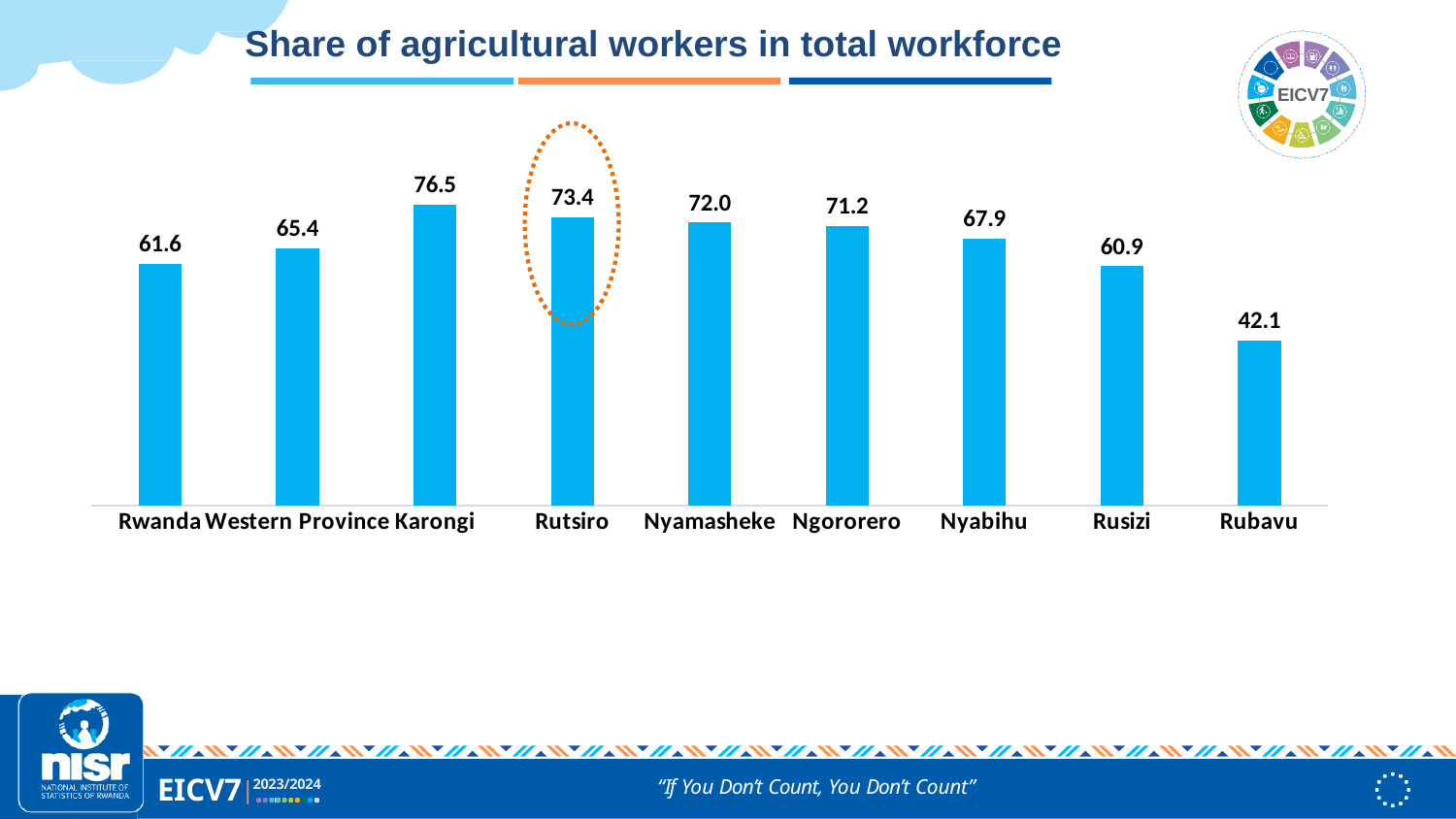
Which category has the highest share of agricultural workers? Karongi What is the difference between the values for Rutsiro and Rwanda? 11.8 How many categories are shown on the x axis? 9 What kind of chart is shown on the slide? Bar chart Which has a larger value, Nyamasheke or Nyabihu? Nyamasheke What is the difference between the values for Karongi and Rubavu? 34.4 What value is shown for Rwanda? 61.6 What is the share of agricultural workers in the total workforce for Rutsiro? 73.4 What value is shown for Rubavu? 42.1 What value is shown for Western Province? 65.4 Which bar is highlighted with a dashed orange circle? Rutsiro Which category has the lowest share of agricultural workers? Rubavu